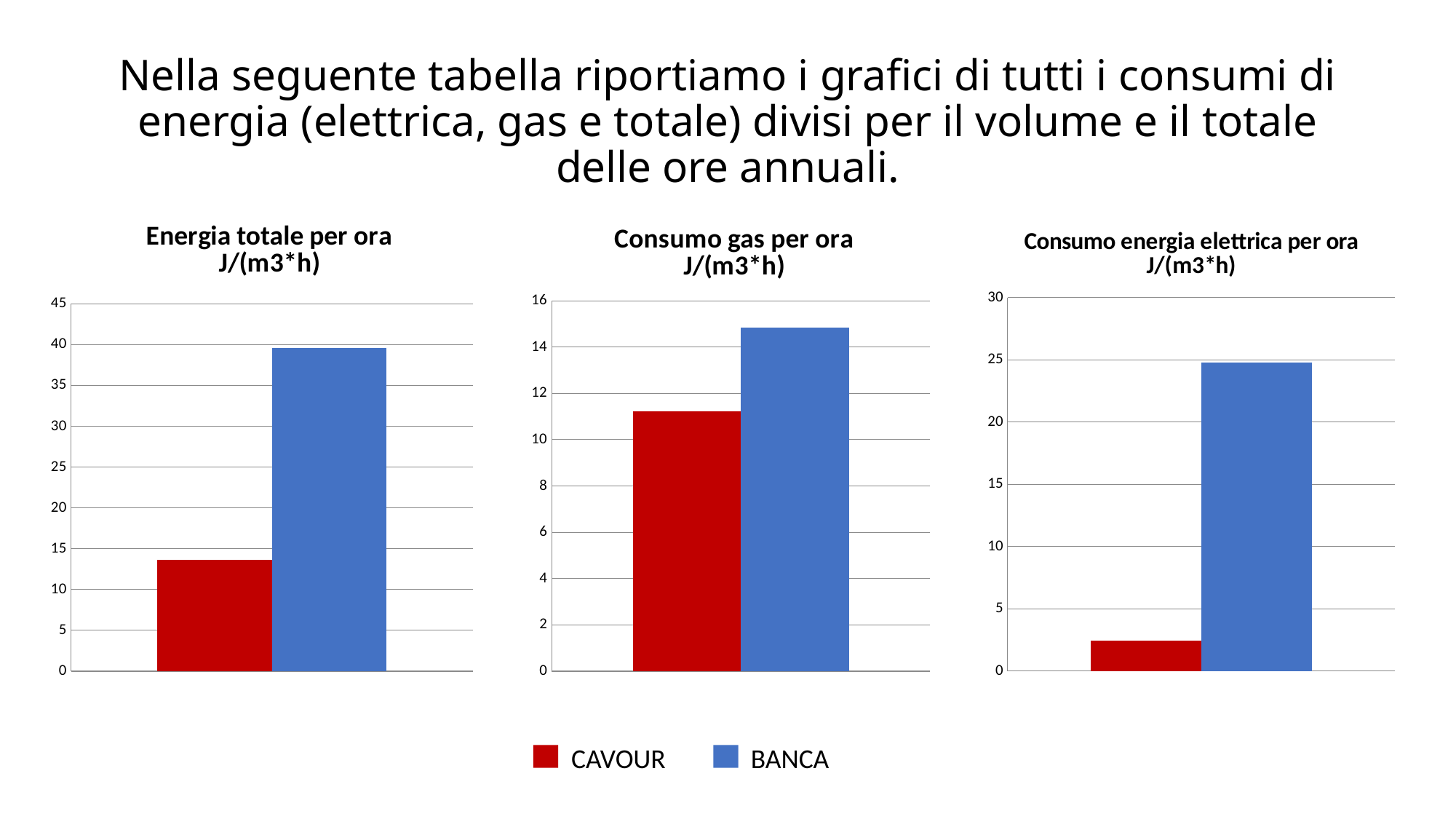
In the "Consumo gas per ora J/(m3*h)" chart, is BANCA or CAVOUR larger? BANCA In the "Energia totale per ora J/(m3*h)" chart, is the value for CAVOUR greater or less than 15? less In the "Consumo gas per ora J/(m3*h)" chart, is the value for CAVOUR greater or less than 10? greater How many bars are plotted in the "Consumo energia elettrica per ora J/(m3*h)" chart? 2 In the "Energia totale per ora J/(m3*h)" chart, is the value for BANCA greater or less than 35? greater Which colour represents CAVOUR in the legend? red In the "Energia totale per ora J/(m3*h)" chart, which series has the higher value? BANCA What kind of chart is "Energia totale per ora J/(m3*h)"? bar chart In the "Consumo gas per ora J/(m3*h)" chart, which series has the lower value? CAVOUR How many series does the shared legend list? 2